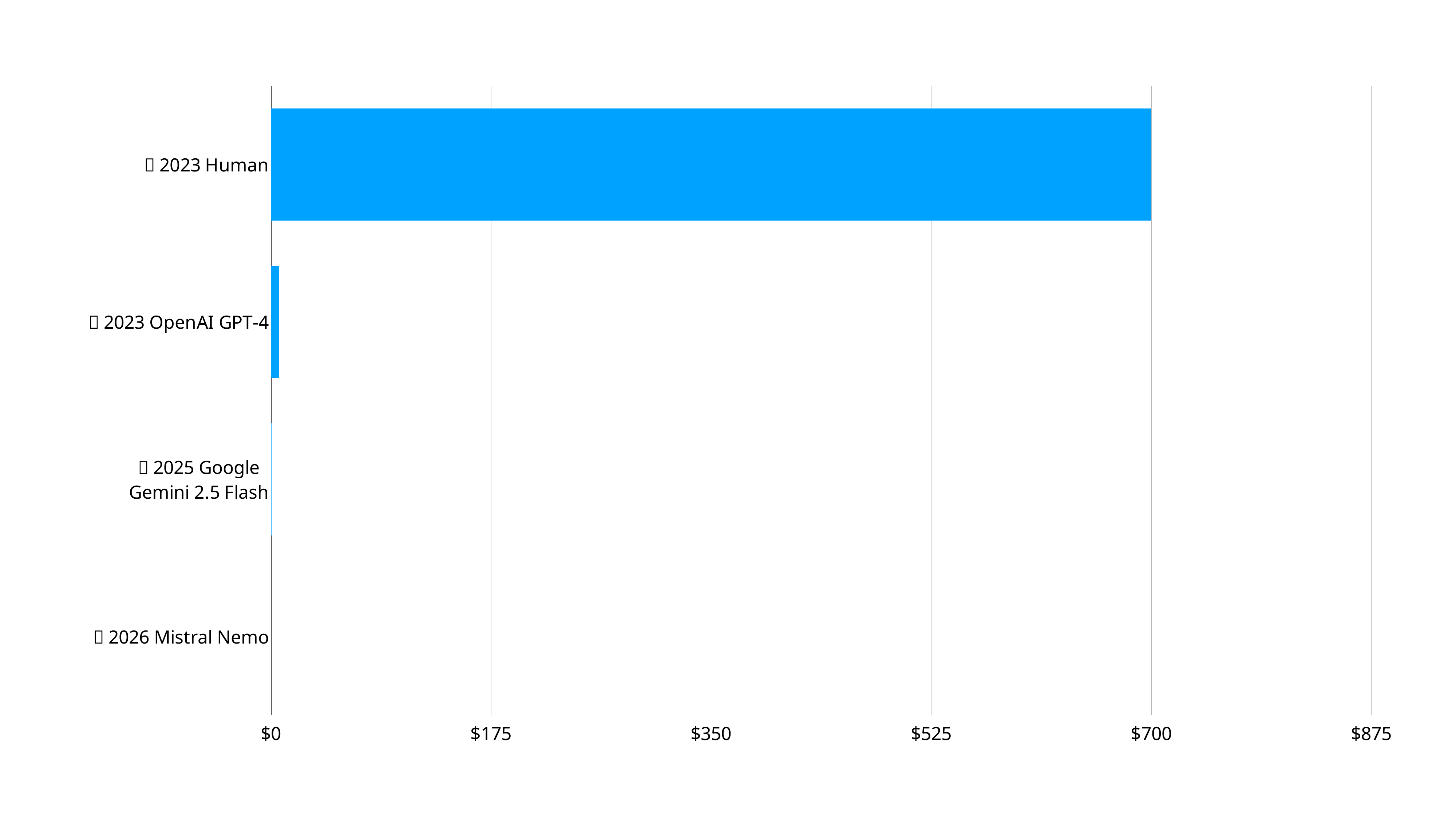
Which is larger, the value for 2023 Human or the value for 2023 OpenAI GPT-4? 2023 Human Which category has the highest value in the chart? 2023 Human Is the value for 2023 OpenAI GPT-4 greater or less than $175? less Is the value for 2025 Google Gemini 2.5 Flash greater or less than $175? less What is the highest value shown on the horizontal axis of the chart? $875 What kind of chart is shown on the slide? bar chart Is the value for 2026 Mistral Nemo greater or less than $175? less What is the value for 2023 Human? $700 What colour are the bars in the chart? blue How many categories are plotted in the chart? 4 Which is larger, the value for 2023 OpenAI GPT-4 or the value for 2025 Google Gemini 2.5 Flash? 2023 OpenAI GPT-4